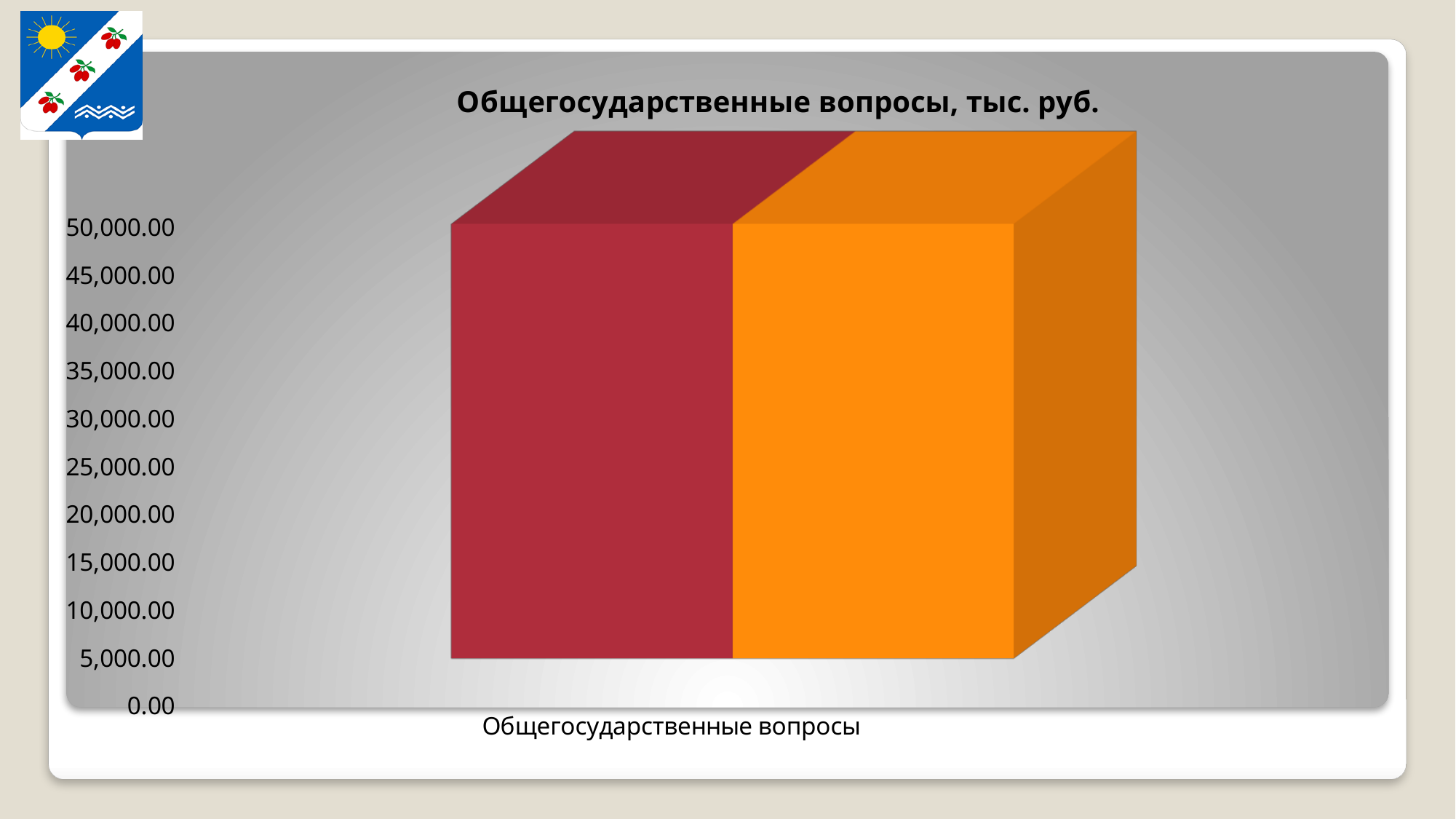
How many categories are shown on the x axis of the chart? 1 Is the value of the red bar greater or less than 40,000.00? greater What kind of chart is shown on the slide? bar chart What is the label of the category on the x axis? Общегосударственные вопросы What is the lowest tick value shown on the vertical axis? 0.00 Is the value of the orange bar greater or less than 40,000.00? greater Is the value of the red bar greater or less than 30,000.00? greater What is the highest tick value shown on the vertical axis? 50,000.00 How many bars are plotted in the chart? 2 What is the title of the chart? Общегосударственные вопросы, тыс. руб.